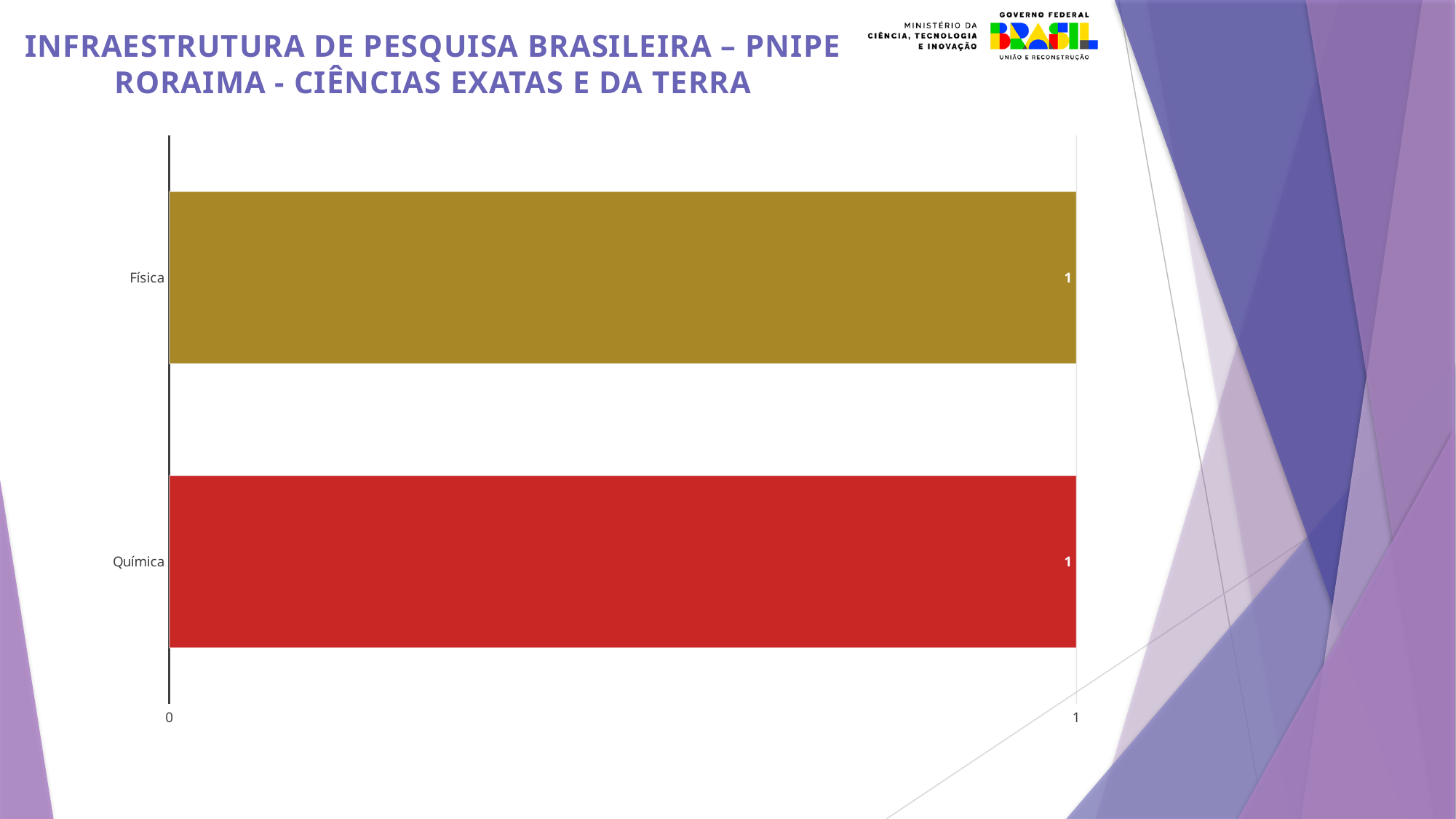
What colour is the bar for Química? red What is the total of the values for Física and Química? 2 What is the difference between the values for Física and Química? 0 What is the value for Física? 1 What kind of chart is shown on the slide? bar chart Which categories are listed on the vertical axis of the chart? Física and Química What is the value for Química? 1 Do the values for Física and Química differ? No, both are 1 How many categories are shown in the chart? 2